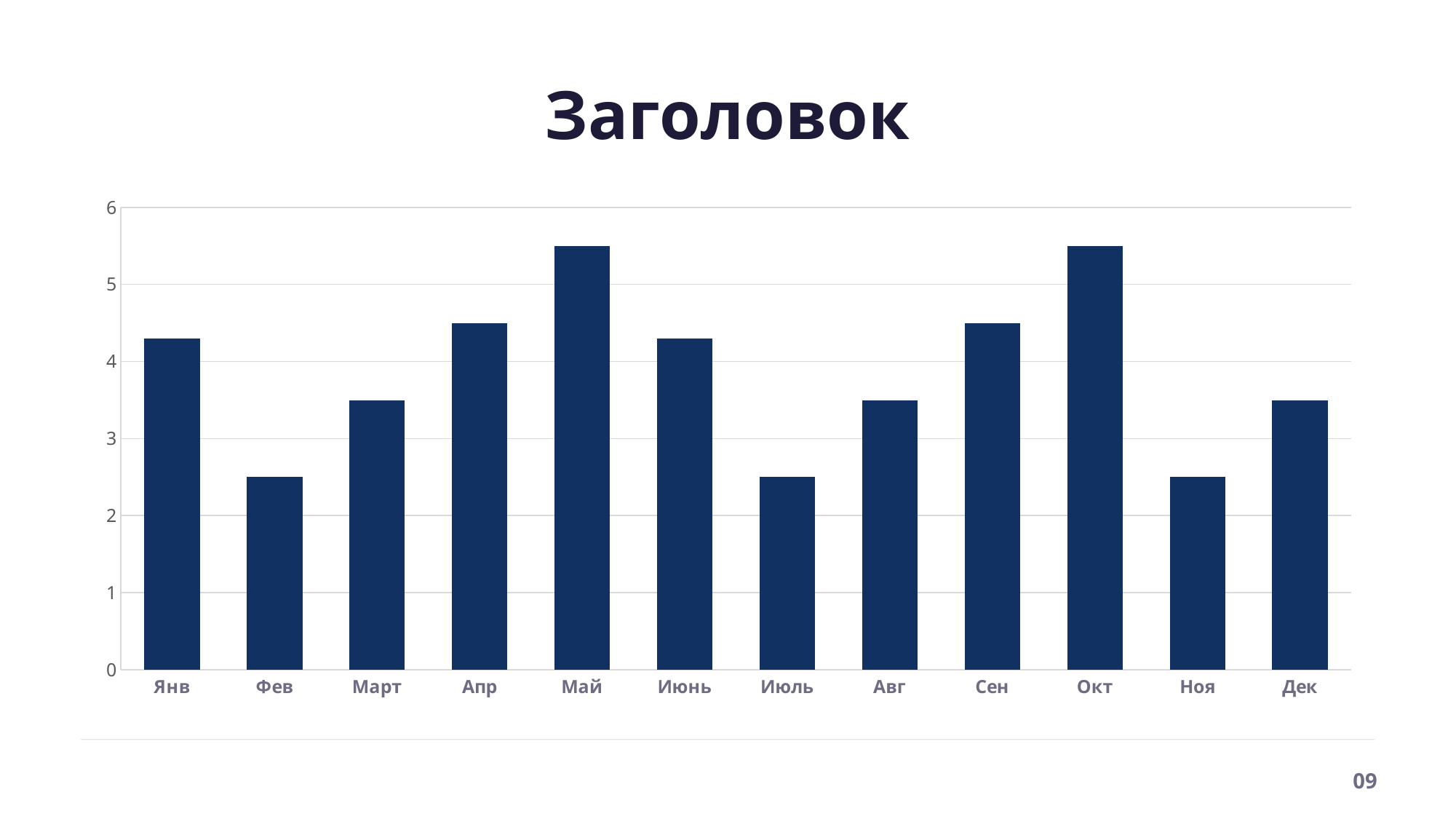
Is the value for Фев greater or less than 3? less Is the value for Май greater or less than 5? greater Is the value for Март greater or less than 4? less How many categories are shown on the x axis of the chart? 12 What kind of chart is shown on the slide? bar chart Which is larger, the value for Апр or the value for Март? Апр Does the value rise or fall from Янв to Фев? fall What is the title of the slide? Заголовок Which is larger, the value for Май or the value for Фев? Май